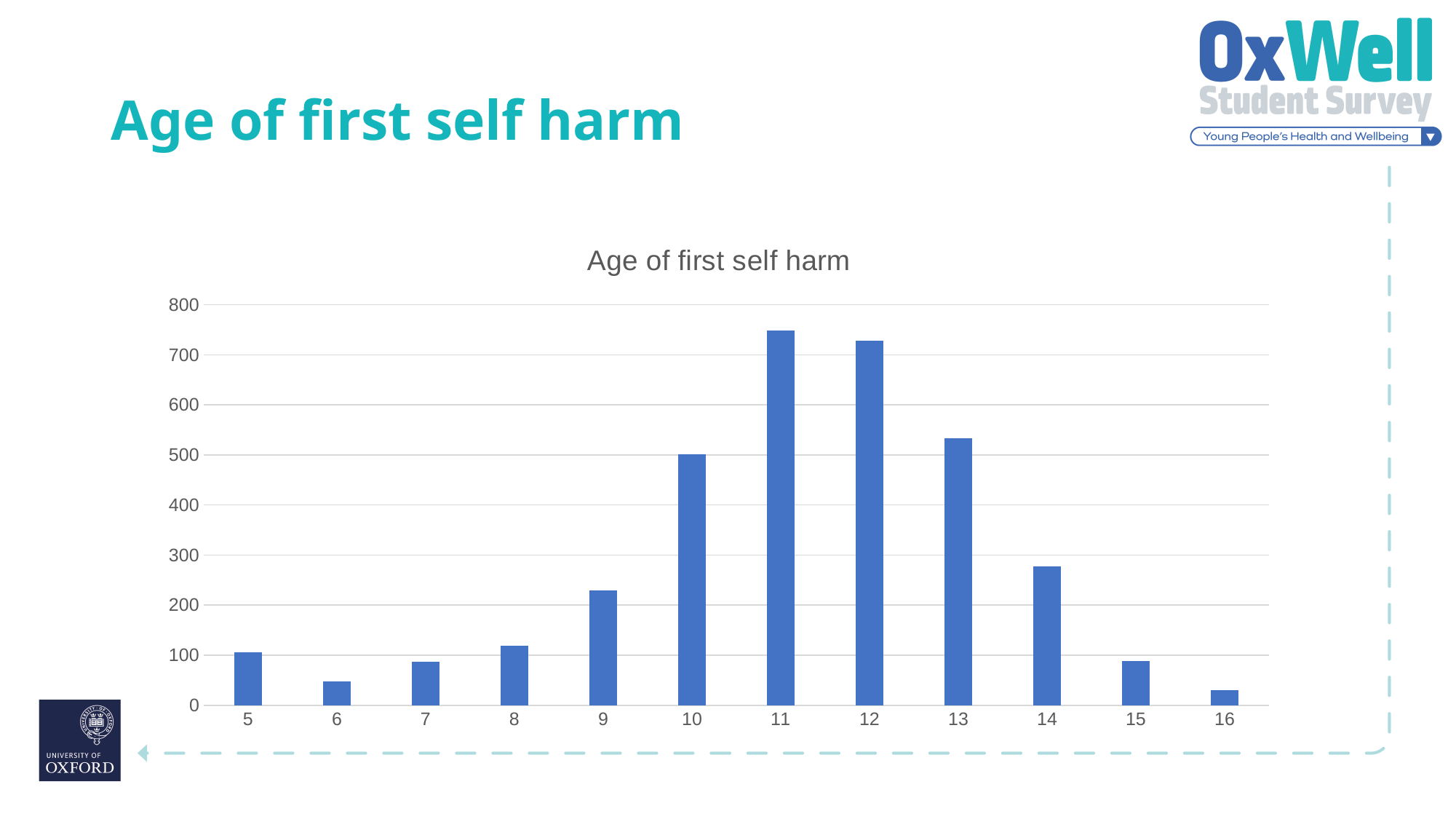
Which age has the lowest bar? 16 Do the values rise or fall from age 11 to age 16? fall Is the value for age 11 greater or less than 700? greater What kind of chart is shown on the slide? bar chart What is the title of the chart? Age of first self harm Is the value for age 6 greater or less than 100? less Is the value for age 13 greater or less than 500? greater Which age has the highest bar? 11 Which is larger, the value for age 13 or the value for age 14? 13 How many age categories are shown on the x axis? 12